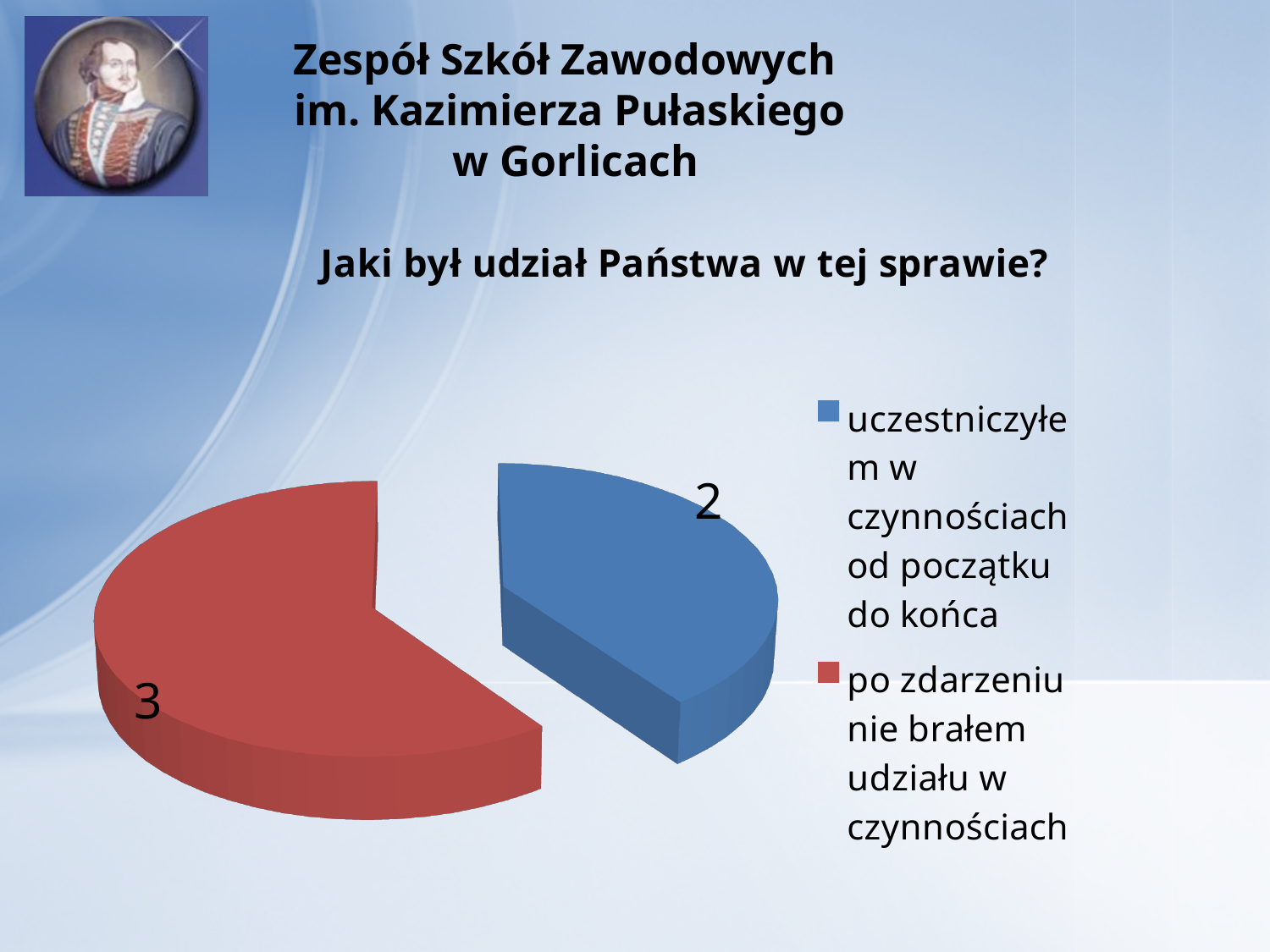
Which category has the smallest slice of the pie? uczestniczyłem w czynnościach od początku do końca What share of the pie does "po zdarzeniu nie brałem udziału w czynnościach" represent? 60% Which category has the largest slice of the pie? po zdarzeniu nie brałem udziału w czynnościach What colour is the slice for "uczestniczyłem w czynnościach od początku do końca"? blue How many slices does the pie chart have? 2 How many entries does the legend list? 2 What is the difference between the value for "po zdarzeniu nie brałem udziału w czynnościach" and the value for "uczestniczyłem w czynnościach od początku do końca"? 1 What kind of chart is shown on the slide? pie chart What is the value for "po zdarzeniu nie brałem udziału w czynnościach"? 3 What share of the pie does "uczestniczyłem w czynnościach od początku do końca" represent? 40% What is the value for "uczestniczyłem w czynnościach od początku do końca"? 2 Which is larger: the value for "uczestniczyłem w czynnościach od początku do końca" or the value for "po zdarzeniu nie brałem udziału w czynnościach"? po zdarzeniu nie brałem udziału w czynnościach